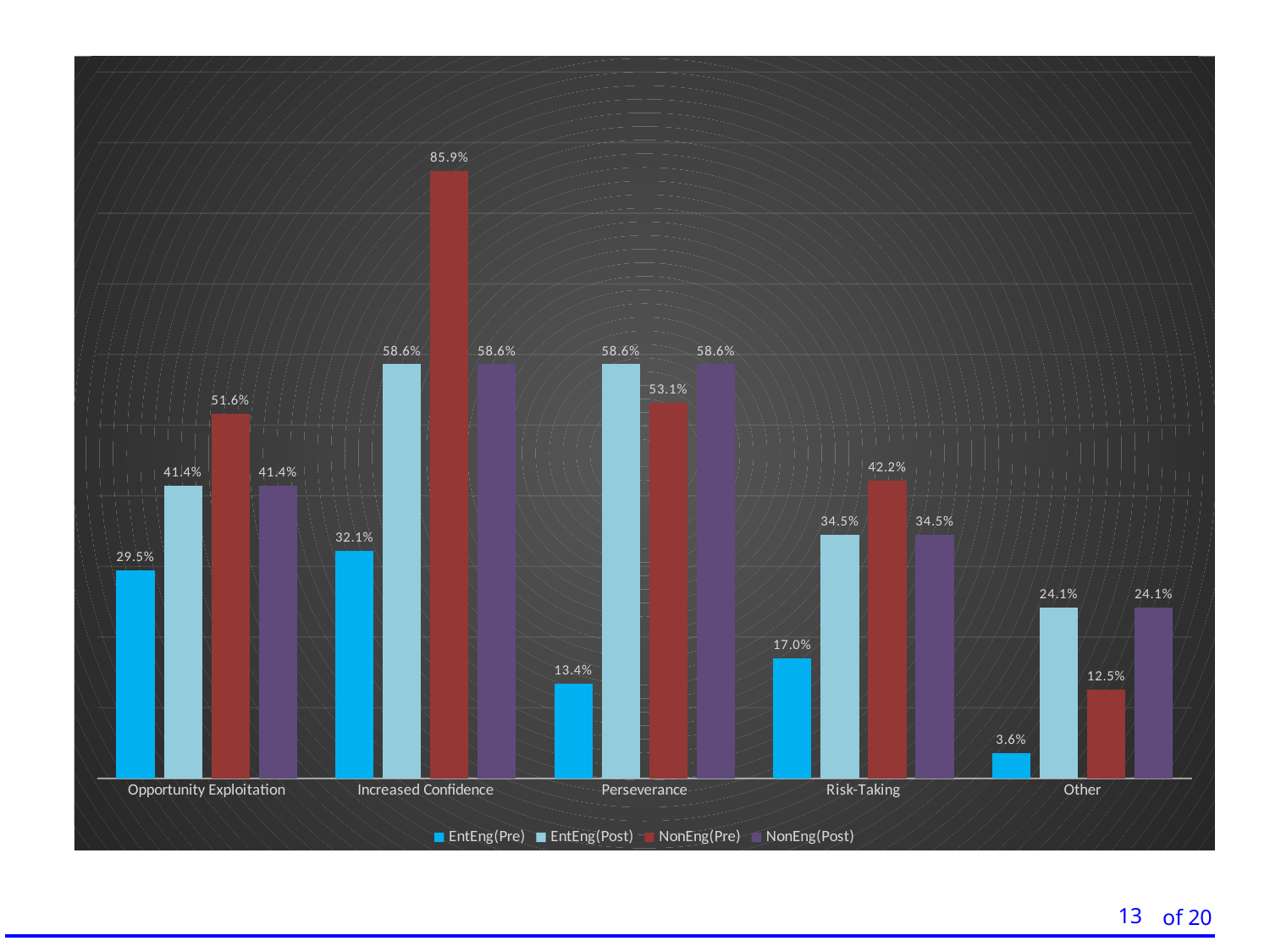
How many series does the legend list? 4 How many categories are shown on the x axis? 5 What is the value for EntEng(Post) in the Risk-Taking category? 34.5% What is the value for NonEng(Pre) in the Increased Confidence category? 85.9% What is the difference between the NonEng(Pre) and EntEng(Pre) values in the Increased Confidence category? 53.8% What is the value for NonEng(Pre) in the Perseverance category? 53.1% What colour are the NonEng(Pre) bars? Dark red Which is larger in the Perseverance category: EntEng(Post) or NonEng(Pre)? EntEng(Post) Which category has the highest value for the EntEng(Pre) series? Increased Confidence What kind of chart is shown on the slide? Bar chart Which category has the lowest value for the NonEng(Pre) series? Other What is the value for EntEng(Pre) in the Other category? 3.6%